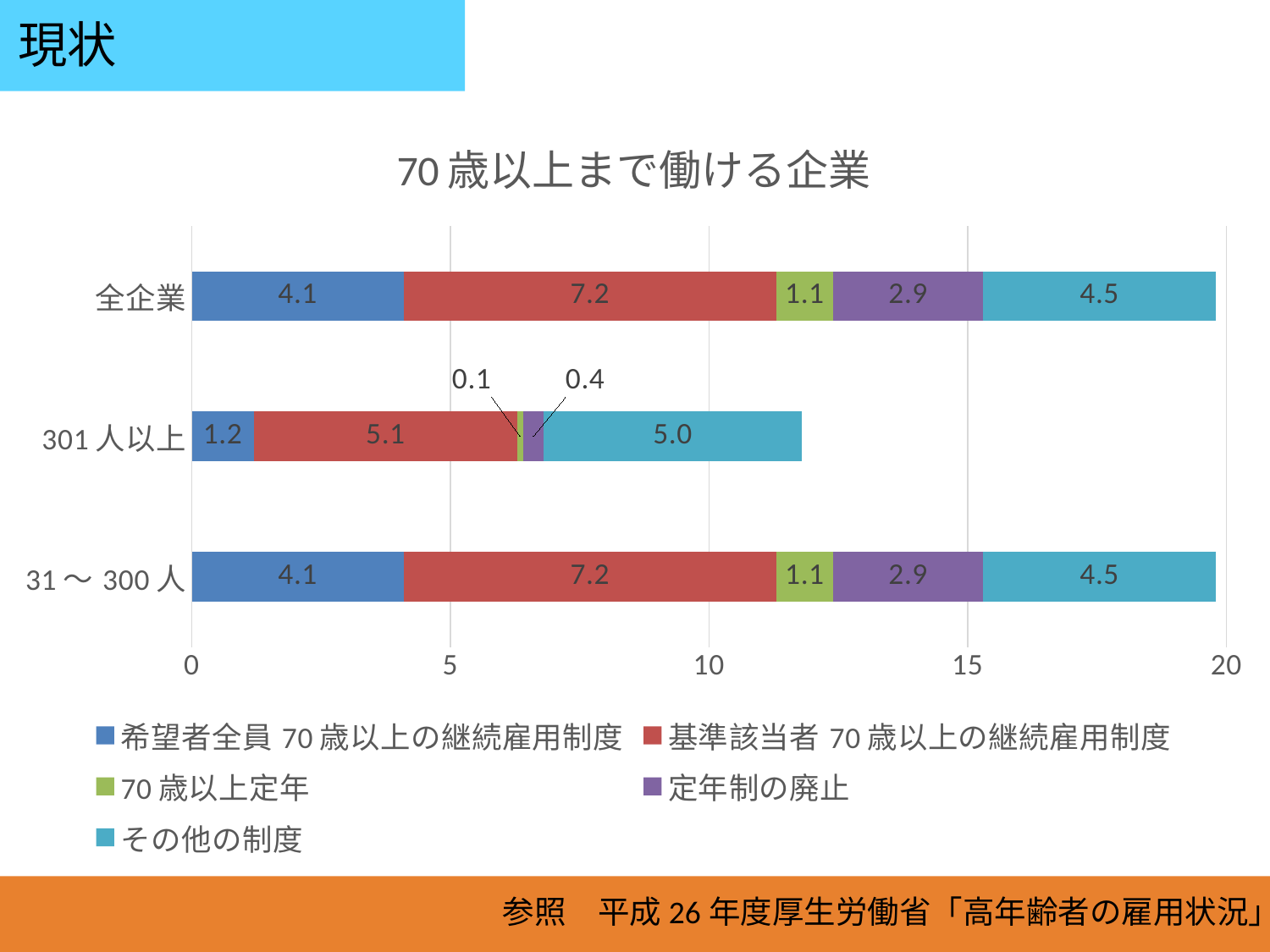
How many series does the legend list? 5 What is the value of 定年制の廃止 for 301人以上? 0.4 What type of chart is shown on the slide? Stacked bar chart Which category has the shortest total bar? 301人以上 What is the difference between the 希望者全員 70歳以上の継続雇用制度 values for 全企業 and 301人以上? 2.9 What is the value of 70歳以上定年 for 31～300人? 1.1 What is the title of the chart? 70歳以上まで働ける企業 What is the total of the stacked bar for 全企業? 19.8 What is the value of その他の制度 for 全企業? 4.5 How many categories are shown on the vertical axis? 3 What is the value of 基準該当者 70歳以上の継続雇用制度 for 301人以上? 5.1 What is the total of the stacked bar for 301人以上? 11.8